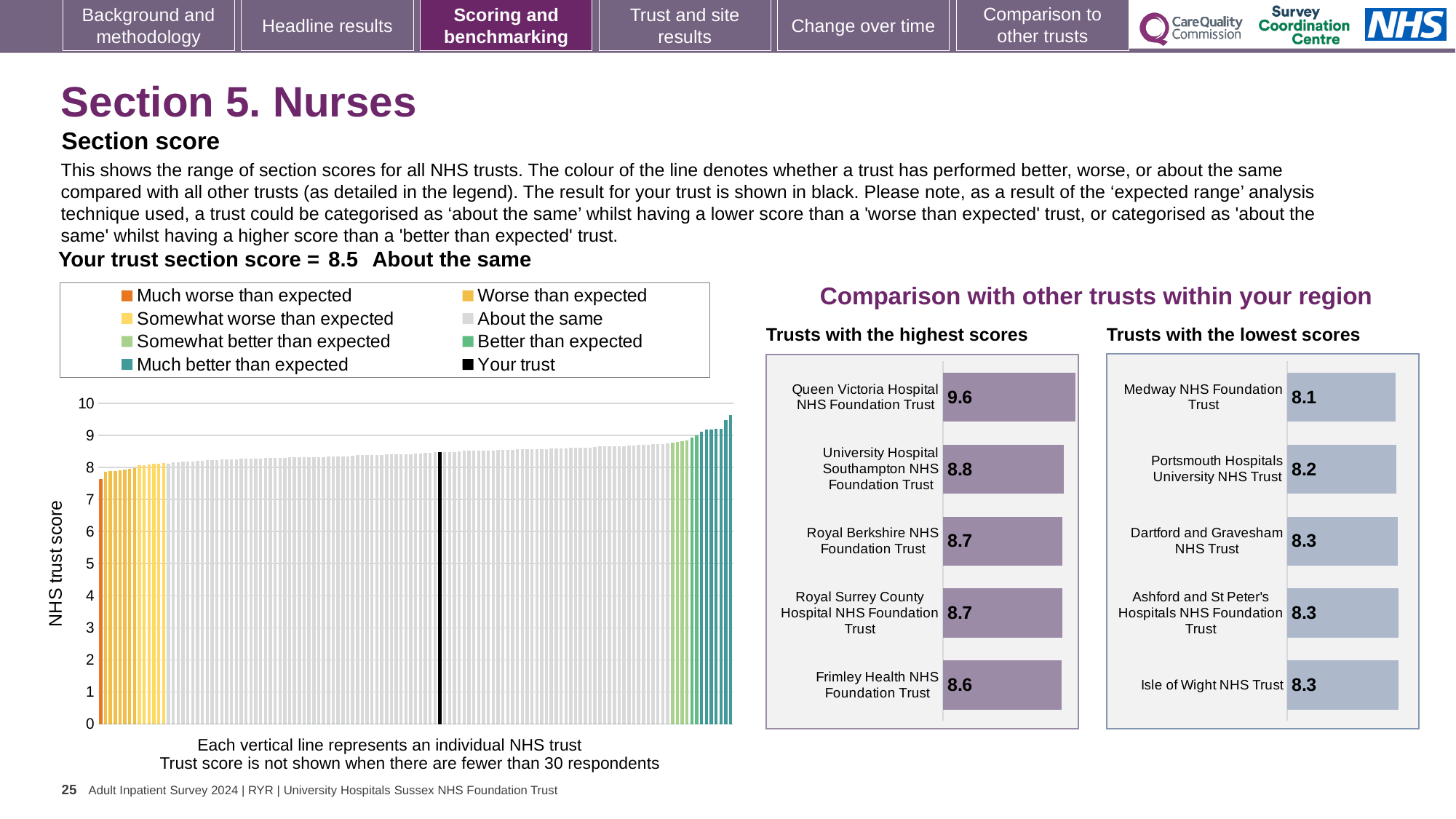
In the main 'NHS trust score' chart, what colour represents 'Your trust' according to the legend? Black How many entries does the legend of the main 'NHS trust score' chart list? 8 In the 'Trusts with the lowest scores' chart, which trust has the lowest score? Medway NHS Foundation Trust Which is larger: the score for University Hospital Southampton NHS Foundation Trust in the 'Trusts with the highest scores' chart, or the score for Dartford and Gravesham NHS Trust in the 'Trusts with the lowest scores' chart? University Hospital Southampton NHS Foundation Trust In the 'Trusts with the lowest scores' chart, what is the score for Medway NHS Foundation Trust? 8.1 In the main 'NHS trust score' chart, do the bar heights rise or fall from left to right? Rise In the 'Trusts with the highest scores' chart, which trust has the highest score? Queen Victoria Hospital NHS Foundation Trust What kind of chart is the main 'NHS trust score' chart on the left of the slide? Bar chart In the 'Trusts with the lowest scores' chart, what is the difference between the scores of Portsmouth Hospitals University NHS Trust and Medway NHS Foundation Trust? 0.1 In the 'Trusts with the highest scores' chart, what is the difference between the scores of Queen Victoria Hospital NHS Foundation Trust and Frimley Health NHS Foundation Trust? 1.0 In the 'Trusts with the highest scores' chart, what is the score for Queen Victoria Hospital NHS Foundation Trust? 9.6 How many trusts are shown in the 'Trusts with the highest scores' chart? 5